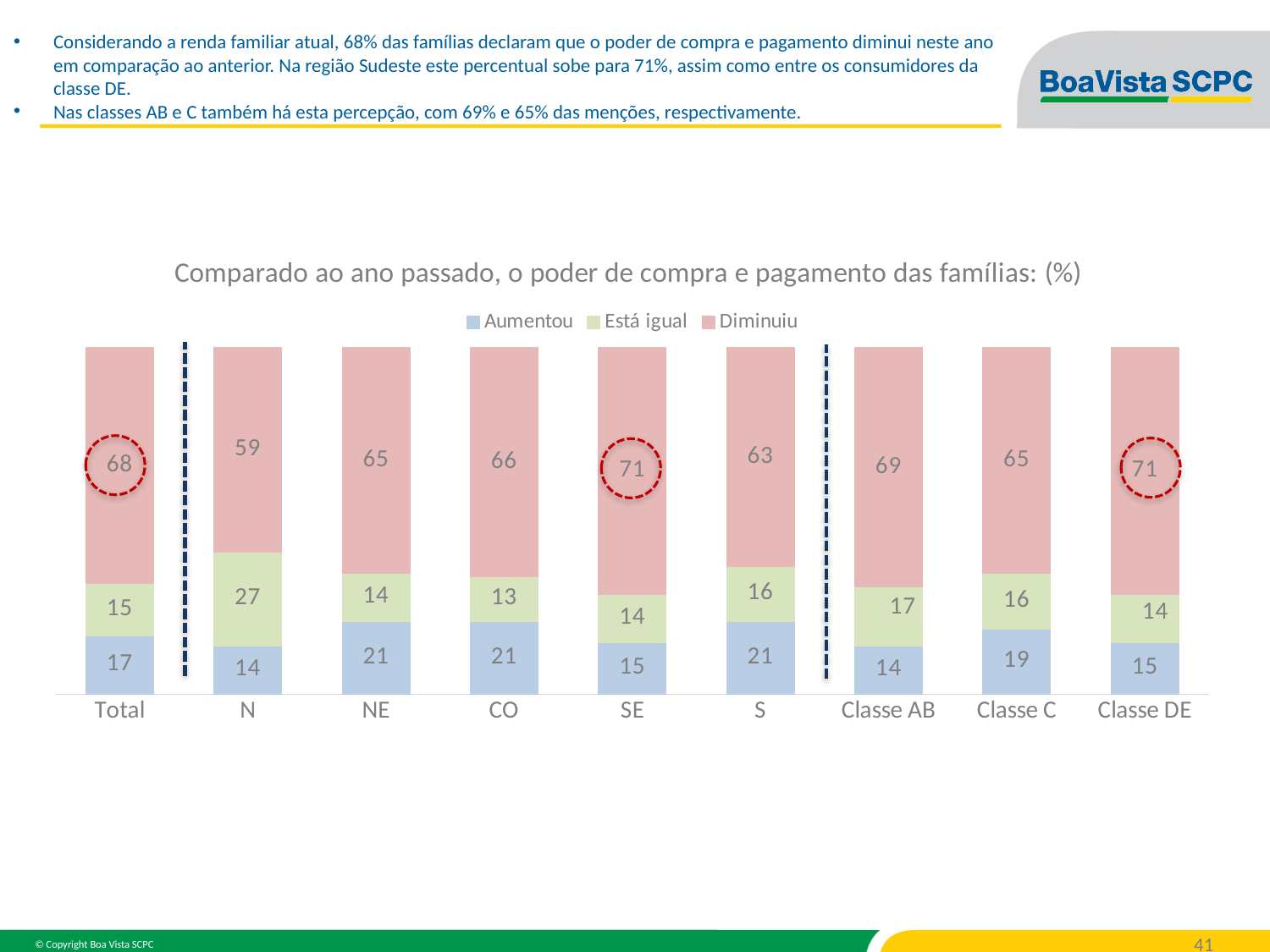
What is the value of 'Diminuiu' for the Total category? 68 How many categories are shown along the x axis? 9 Which category has the lowest value for 'Diminuiu'? N What is the difference between the 'Diminuiu' values for SE and S? 8 Which category has the lowest value for 'Está igual'? CO What is the value of 'Está igual' for the N category? 27 What is the value of 'Aumentou' for Classe C? 19 What is the total of the stacked bar for Classe DE? 100 Which is larger, the 'Aumentou' value for NE or for Classe AB? NE Which category has the highest value for 'Está igual'? N What type of chart is shown on the slide? Stacked bar chart How many series does the legend list? 3